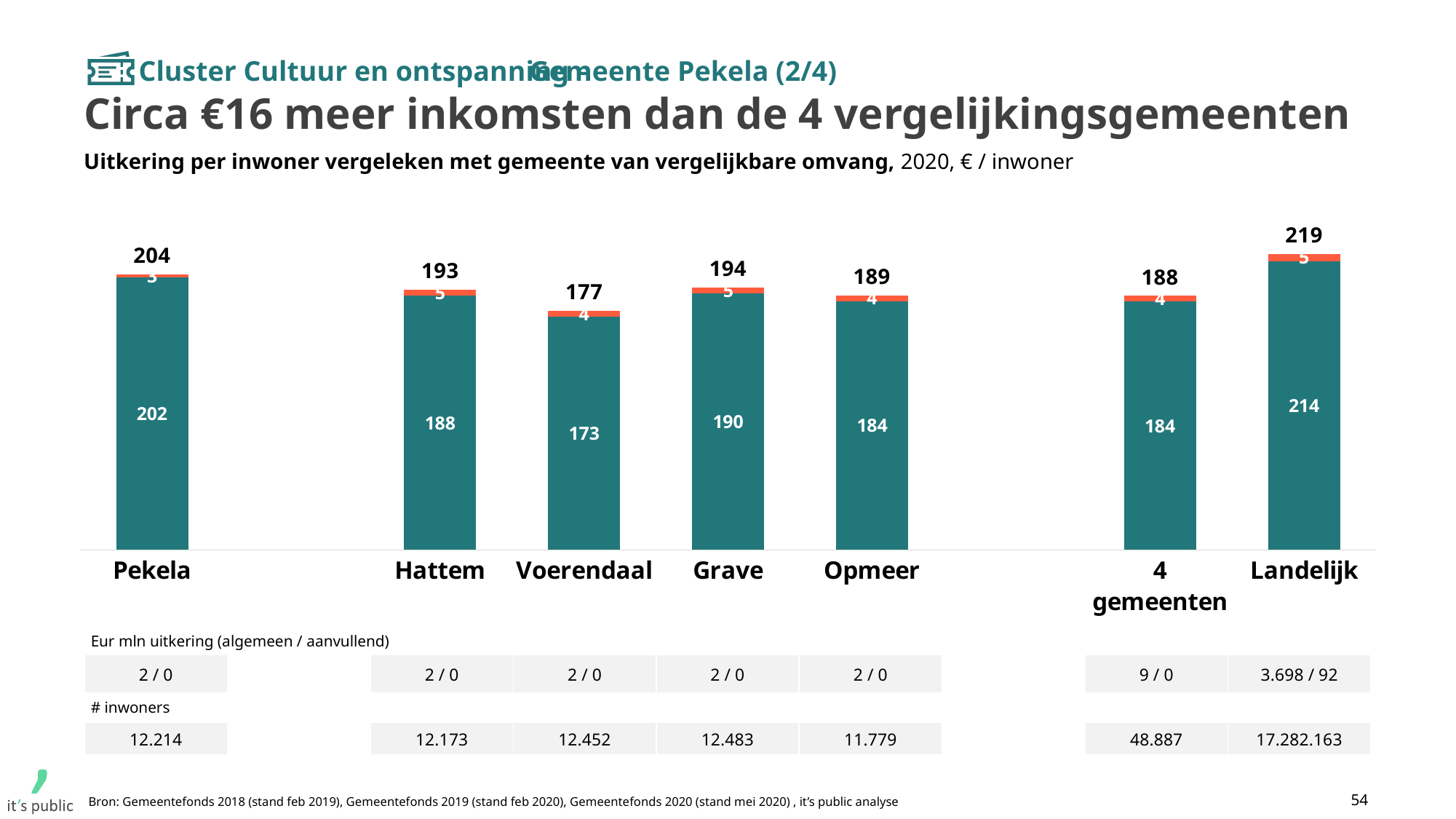
What is the total value shown above the bar for Landelijk? 219 Which has a larger total value, Grave or Opmeer? Grave What is the difference between the total for Pekela and the total for 4 gemeenten? 16 What is the value of the orange (upper) segment for Hattem? 5 Which category has the lowest total value? Voerendaal What is the total of the stacked bar for 4 gemeenten? 188 What is the number of inhabitants (# inwoners) listed for Pekela below the chart? 12.214 How many bars are shown in the chart? 7 What is the value of the teal (lower) segment for Voerendaal? 173 What kind of chart is shown on the slide? Stacked bar chart Which category has the highest total value? Landelijk What is the total value shown above the bar for Pekela? 204